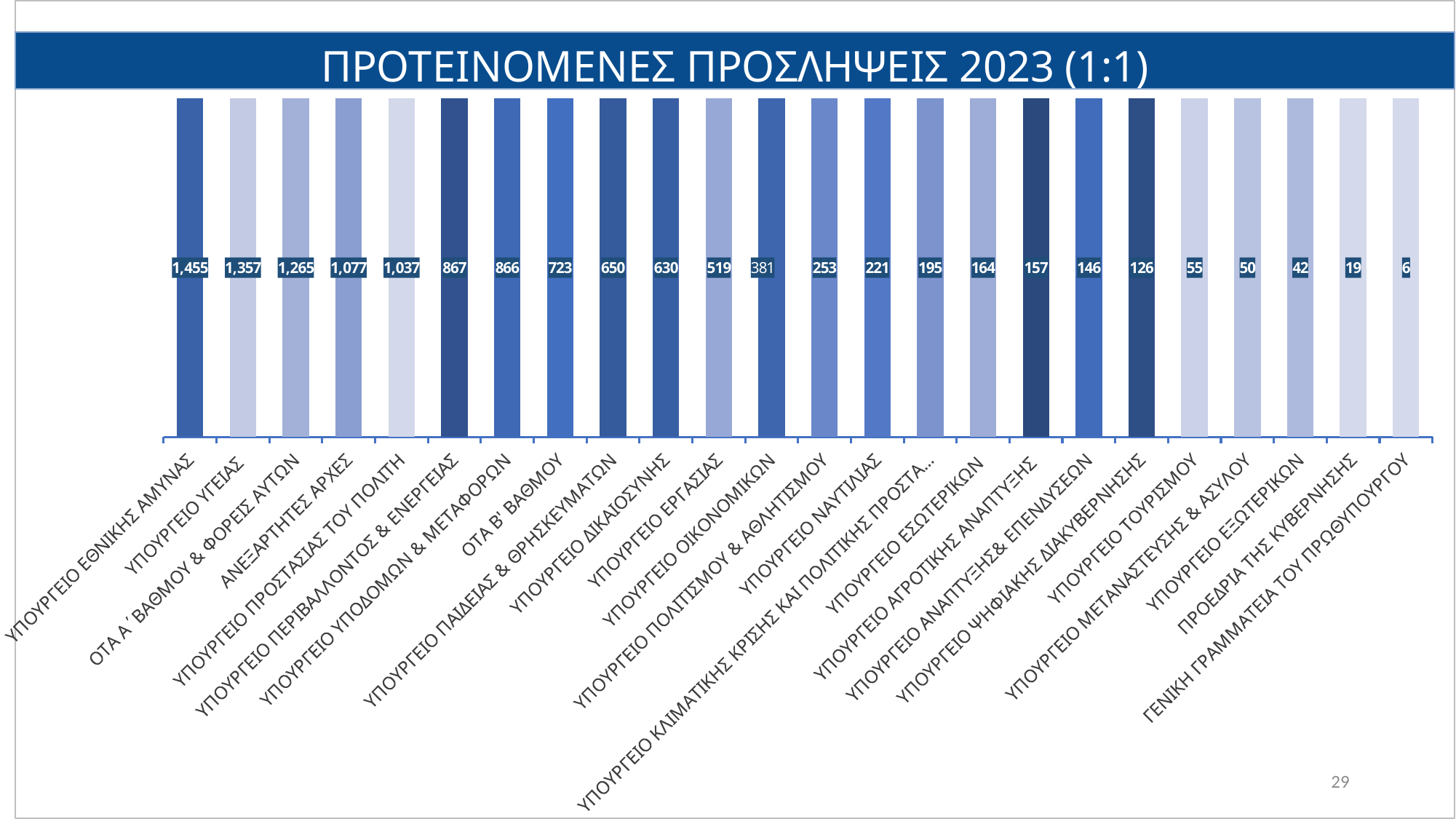
How many categories are shown in the chart? 24 What is the difference between the values for ΥΠΟΥΡΓΕΙΟ ΥΓΕΙΑΣ and ΥΠΟΥΡΓΕΙΟ ΠΡΟΣΤΑΣΙΑΣ ΤΟΥ ΠΟΛΙΤΗ? 320 What value is shown for ΥΠΟΥΡΓΕΙΟ ΕΘΝΙΚΗΣ ΑΜΥΝΑΣ? 1,455 What value is shown for ΥΠΟΥΡΓΕΙΟ ΔΙΚΑΙΟΣΥΝΗΣ? 630 Which category has the highest value? ΥΠΟΥΡΓΕΙΟ ΕΘΝΙΚΗΣ ΑΜΥΝΑΣ What value is shown for ΥΠΟΥΡΓΕΙΟ ΤΟΥΡΙΣΜΟΥ? 55 What is the difference between the values for ΟΤΑ Β' ΒΑΘΜΟΥ and ΥΠΟΥΡΓΕΙΟ ΕΡΓΑΣΙΑΣ? 204 What kind of chart is shown on the slide? Bar chart What is the title of the chart? ΠΡΟΤΕΙΝΟΜΕΝΕΣ ΠΡΟΣΛΗΨΕΙΣ 2023 (1:1) What value is shown for ΥΠΟΥΡΓΕΙΟ ΟΙΚΟΝΟΜΙΚΩΝ? 381 Which has a larger value, ΥΠΟΥΡΓΕΙΟ ΝΑΥΤΙΛΙΑΣ or ΥΠΟΥΡΓΕΙΟ ΕΣΩΤΕΡΙΚΩΝ? ΥΠΟΥΡΓΕΙΟ ΝΑΥΤΙΛΙΑΣ Which category has the lowest value? ΓΕΝΙΚΗ ΓΡΑΜΜΑΤΕΙΑ ΤΟΥ ΠΡΩΘΥΠΟΥΡΓΟΥ